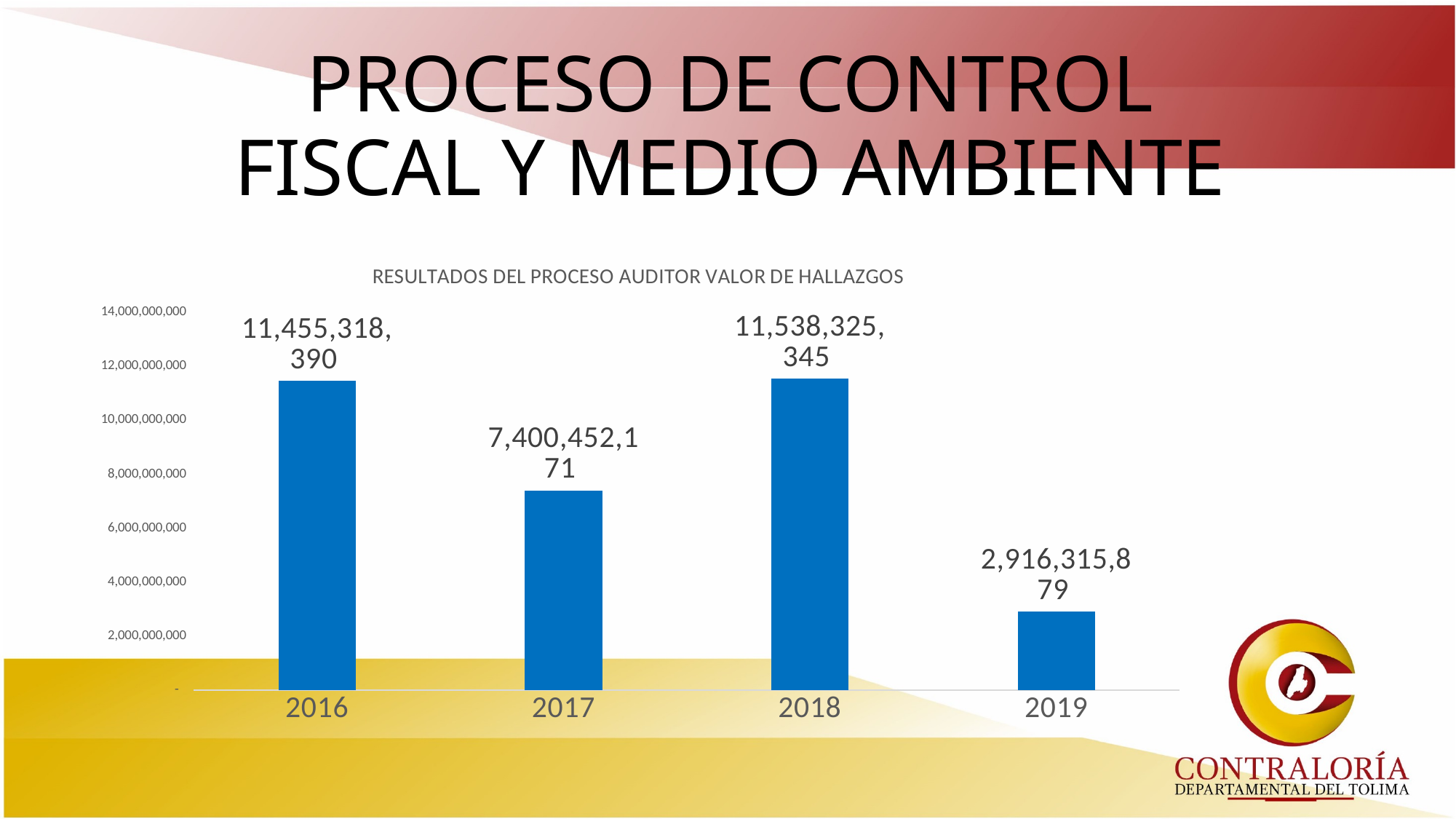
How many years are shown on the x axis of the chart? 4 What is the value for 2017 in the chart? 7,400,452,171 Is the value for 2017 greater or less than 6,000,000,000? greater Which year has the highest value in the chart? 2018 What is the value for 2018 in the chart? 11,538,325,345 Which year has the lowest value in the chart? 2019 Which is larger, the value for 2017 or the value for 2019? 2017 What is the difference between the values for 2018 and 2019? 8,622,009,466 What is the title of the chart? RESULTADOS DEL PROCESO AUDITOR VALOR DE HALLAZGOS What is the value for 2019 in the chart? 2,916,315,879 What is the value for 2016 in the chart? 11,455,318,390 What is the difference between the values for 2016 and 2017? 4,054,866,219